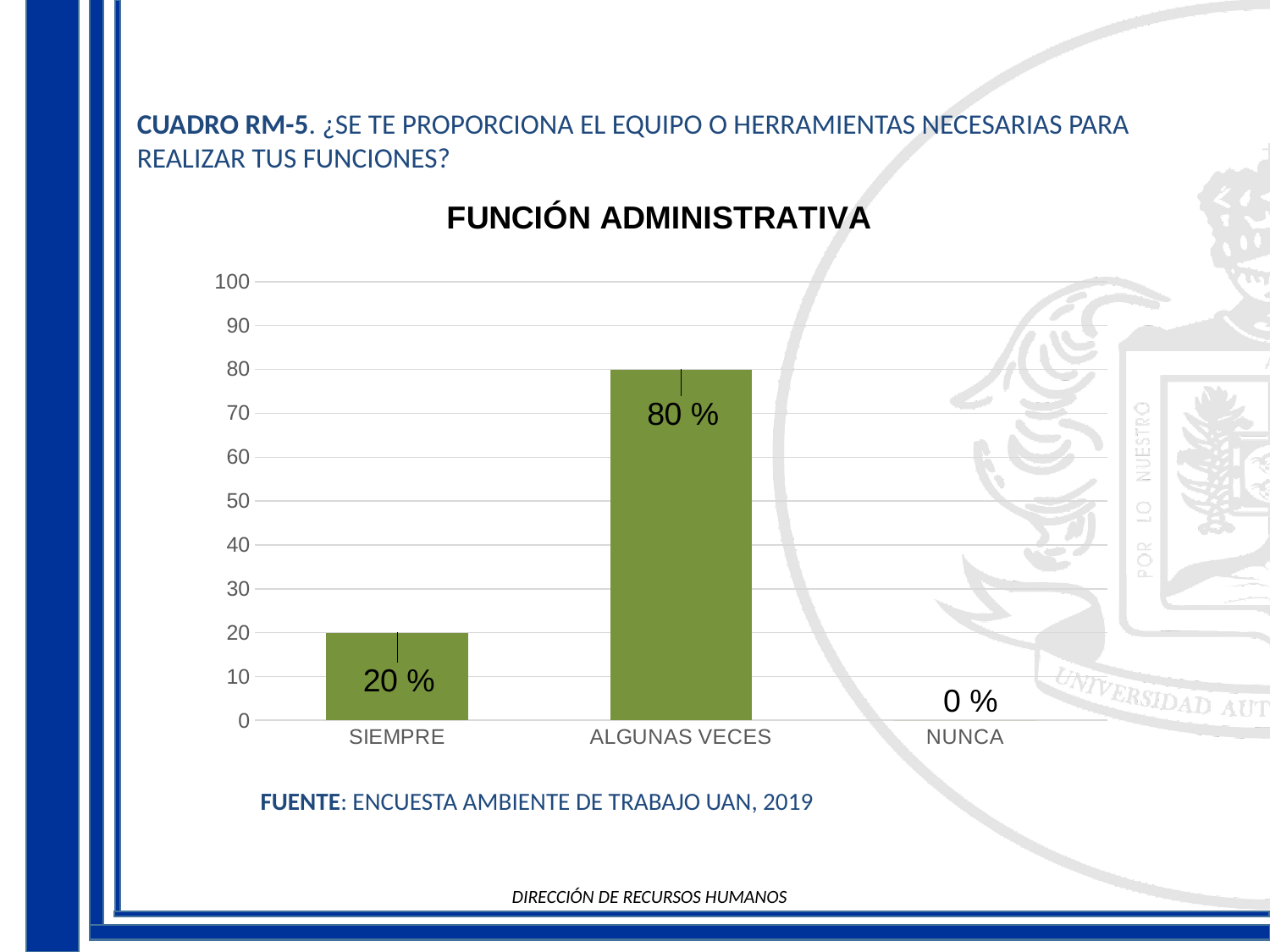
Which is larger, the value for SIEMPRE or the value for ALGUNAS VECES? ALGUNAS VECES Which category has the lowest value? NUNCA Is the value for ALGUNAS VECES greater or less than 50? greater What is the value for NUNCA? 0 % Which category has the highest value? ALGUNAS VECES What is the value for SIEMPRE? 20 % What is the difference between the values for ALGUNAS VECES and SIEMPRE? 60 % Is the value for SIEMPRE greater or less than 30? less How many categories are shown on the x axis? 3 What is the title of the chart? FUNCIÓN ADMINISTRATIVA What is the value for ALGUNAS VECES? 80 % What kind of chart is shown on the slide? bar chart